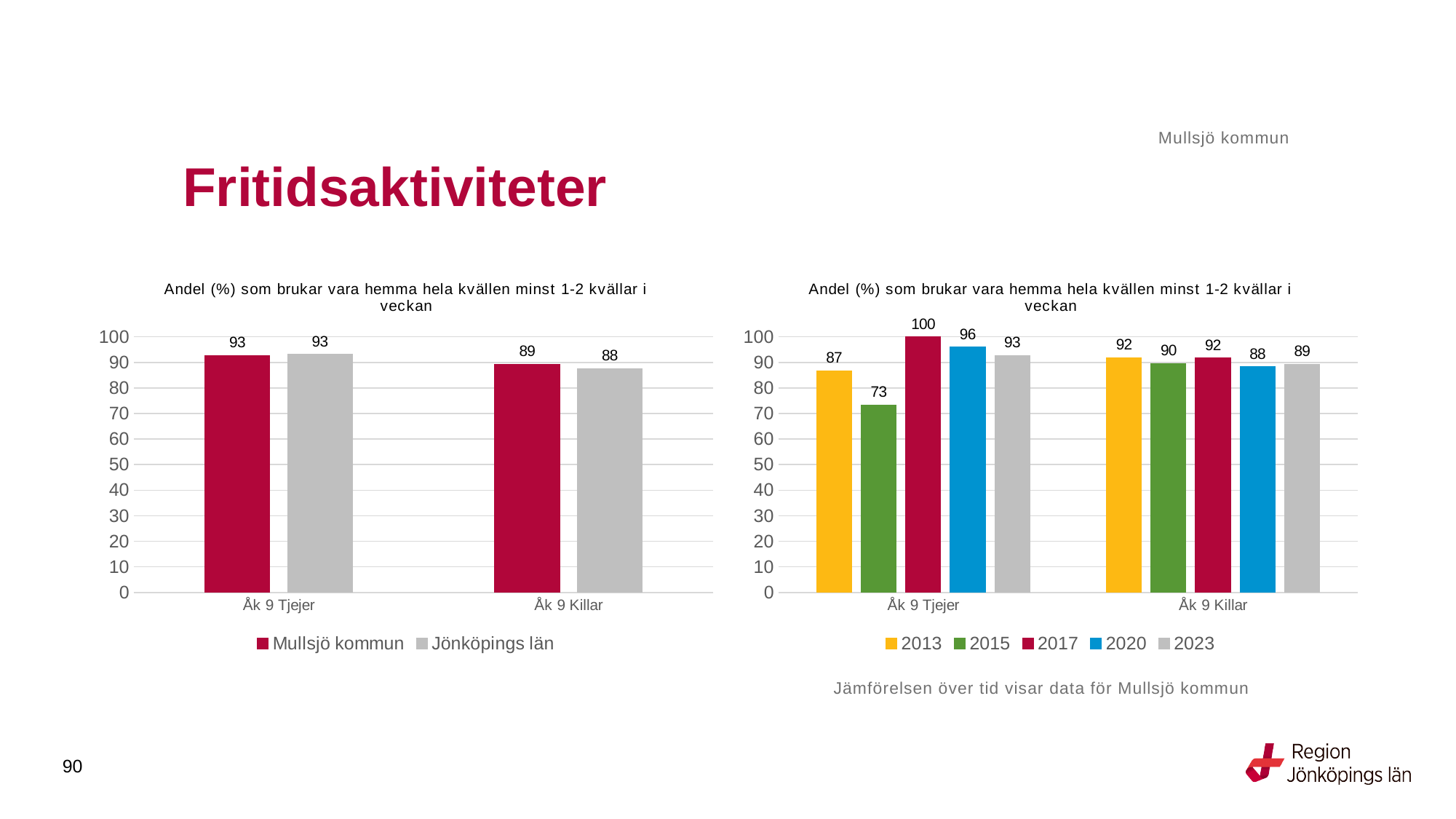
In the right chart, what is the value for 2015 for Åk 9 Tjejer? 73 In the right chart, which year has the highest value for Åk 9 Tjejer? 2017 What kind of chart is the right chart? Bar chart In the right chart, what is the value for 2020 for Åk 9 Killar? 88 In the right chart, what is the difference between the 2017 and 2015 values for Åk 9 Tjejer? 27 In the right chart, which year has the lowest value for Åk 9 Tjejer? 2015 In the left chart, what is the value for Mullsjö kommun for Åk 9 Killar? 89 In the right chart, how many series does the legend list? 5 In the right chart, which is larger for Åk 9 Killar: the 2013 value or the 2020 value? 2013 In the left chart, how many series does the legend list? 2 In the left chart, what is the difference between Mullsjö kommun and Jönköpings län for Åk 9 Killar? 1 In the left chart, what is the value for Jönköpings län for Åk 9 Tjejer? 93